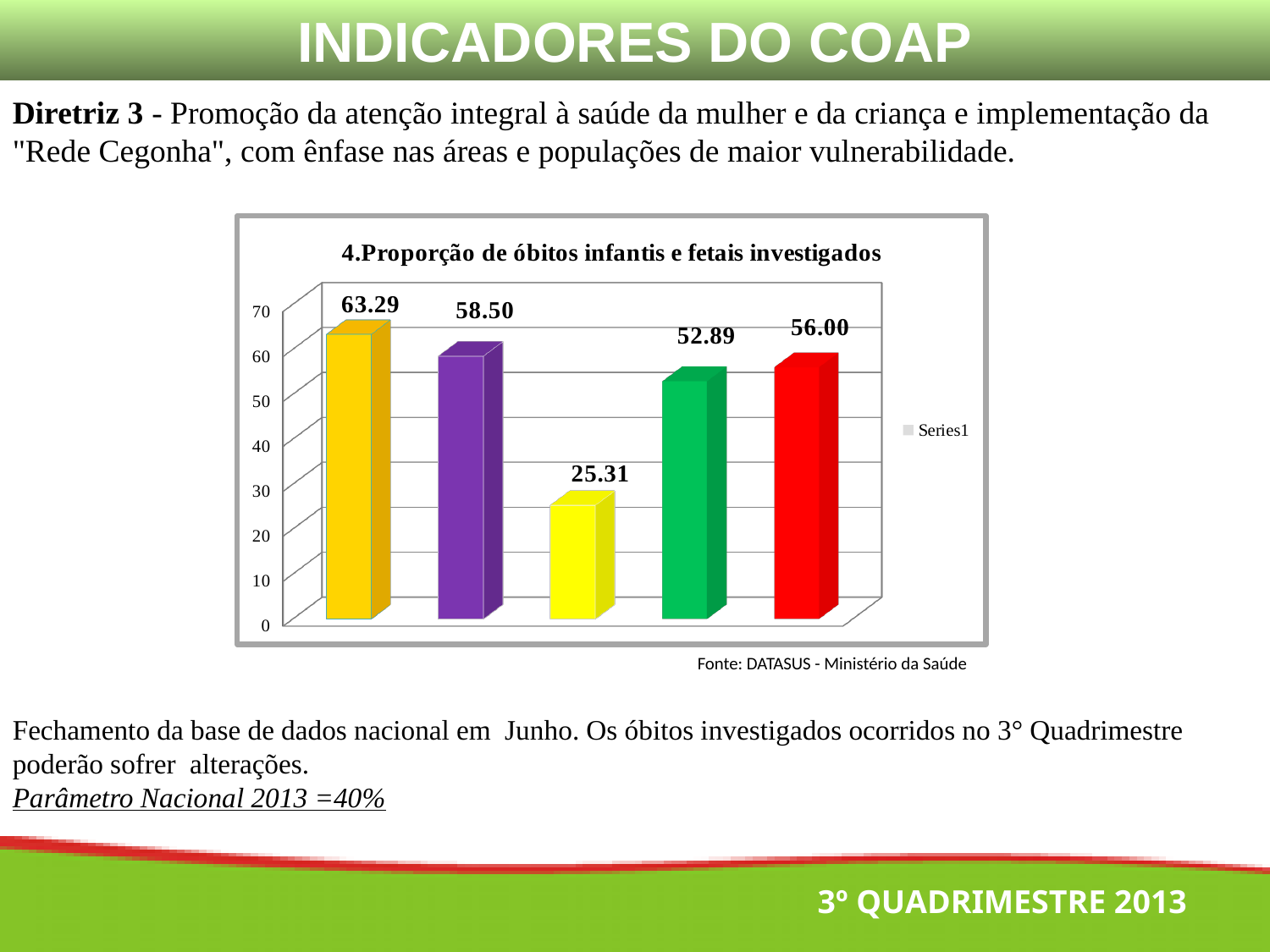
What is the title of the chart? 4.Proporção de óbitos infantis e fetais investigados How many series does the legend list? 1 What is the lowest value shown in the chart? 25.31 What is the difference between the first (orange) bar and the second (purple) bar? 4.79 What is the value shown on the red bar at the far right? 56.00 What is the highest value shown in the chart? 63.29 Which is larger, the green bar or the red bar? the red bar What kind of chart is shown on the slide? bar chart What is the name of the series shown in the legend? Series1 What is the value shown on the yellow bar in the middle of the chart? 25.31 What is the value shown on the first (orange) bar from the left? 63.29 How many bars are plotted in the chart? 5